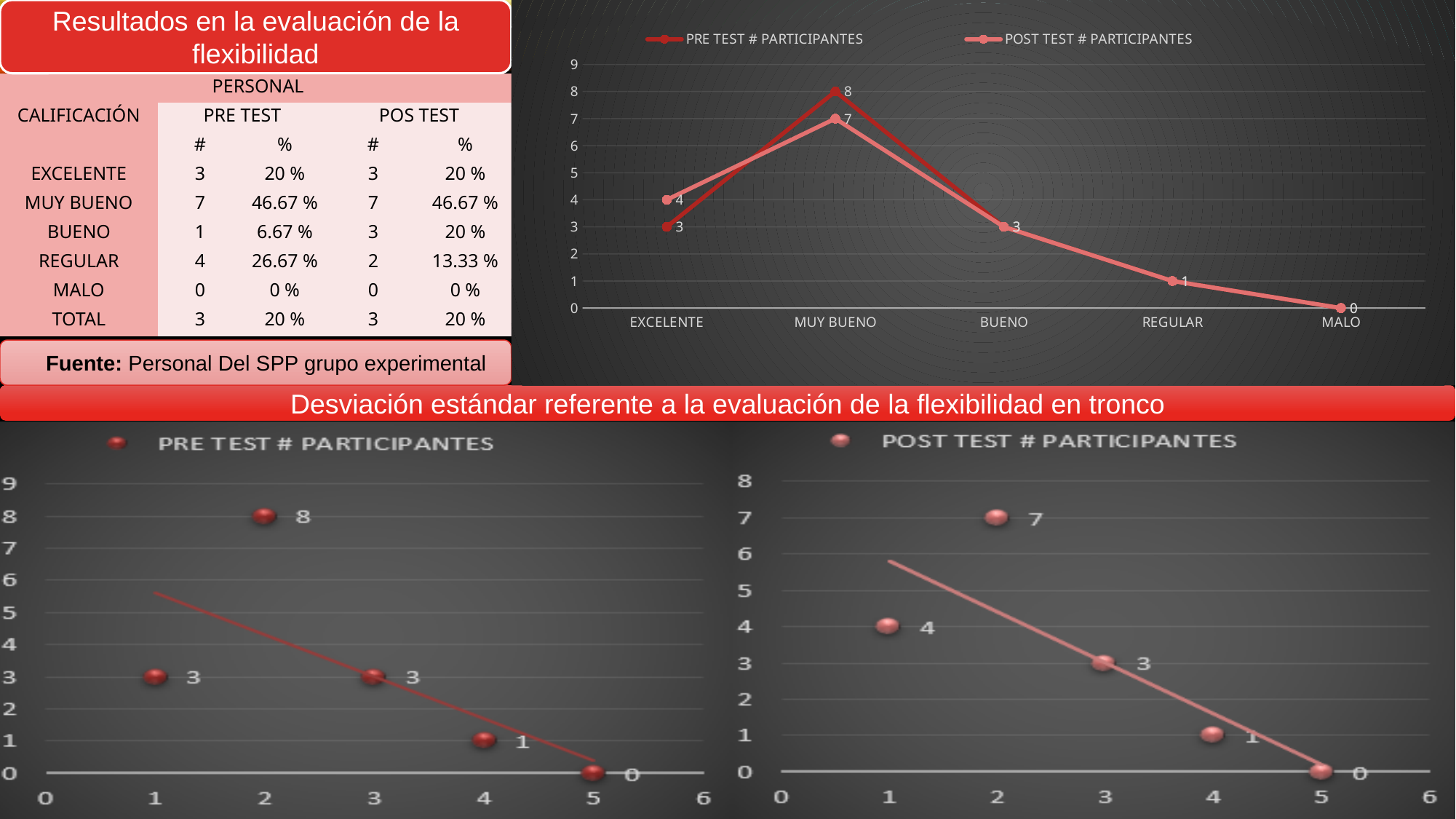
In the top-right line chart, do the POST TEST values rise or fall from MUY BUENO to MALO? Fall How many categories are shown on the x axis of the top-right line chart? 5 In the top-right line chart, what is the PRE TEST # PARTICIPANTES value for MUY BUENO? 8 In the bottom-right POST TEST # PARTICIPANTES scatter chart, what is the value of the point at x = 1? 4 In the bottom-left PRE TEST # PARTICIPANTES scatter chart, what is the value of the point at x = 2? 8 In the top-right line chart, which category has the highest POST TEST # PARTICIPANTES value? MUY BUENO In the top-right line chart, what is the POST TEST # PARTICIPANTES value for EXCELENTE? 4 In the top-right line chart, which category has the lowest PRE TEST # PARTICIPANTES value? MALO What kind of chart is the top-right chart? Line chart How many series does the legend of the top-right line chart list? 2 In the top-right line chart, what is the difference between the PRE TEST and POST TEST values for MUY BUENO? 1 In the top-right line chart, which is larger for EXCELENTE: the PRE TEST value or the POST TEST value? POST TEST